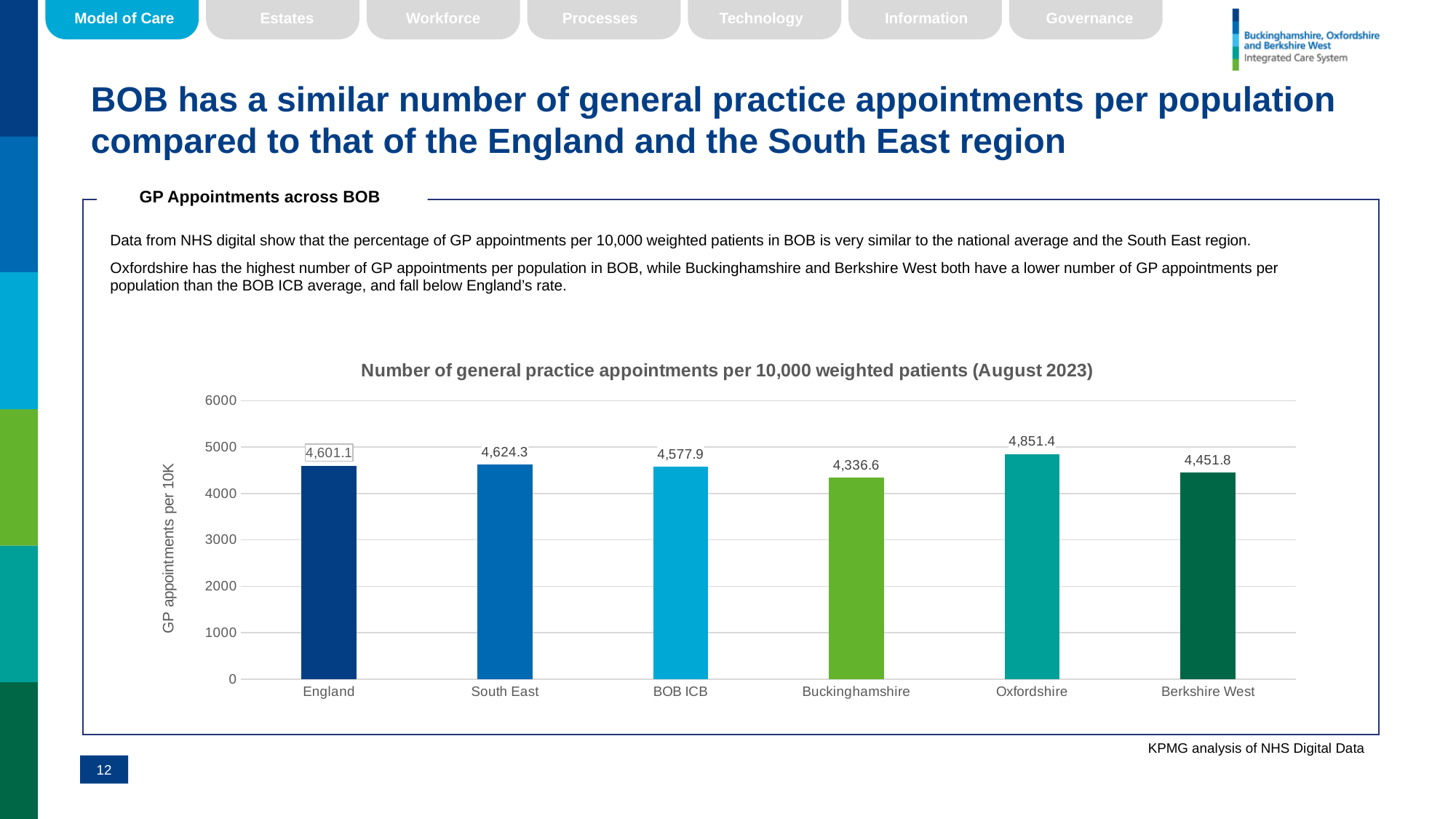
What is the value shown for BOB ICB in the chart? 4,577.9 What is the number of general practice appointments per 10,000 weighted patients for Oxfordshire? 4,851.4 How many categories are shown on the x axis of the chart? 6 Is the value for Buckinghamshire greater or less than 5000? less Which category has the lowest number of general practice appointments per 10,000 weighted patients? Buckinghamshire What is the difference between the values for South East and England? 23.2 Which category has the highest number of general practice appointments per 10,000 weighted patients? Oxfordshire What is the value shown for Berkshire West in the chart? 4,451.8 What is the difference between the values for Oxfordshire and Buckinghamshire? 514.8 What kind of chart is used to show the number of general practice appointments per 10,000 weighted patients? Bar chart Which has a larger value, BOB ICB or Berkshire West? BOB ICB What is the value shown for Buckinghamshire in the chart? 4,336.6